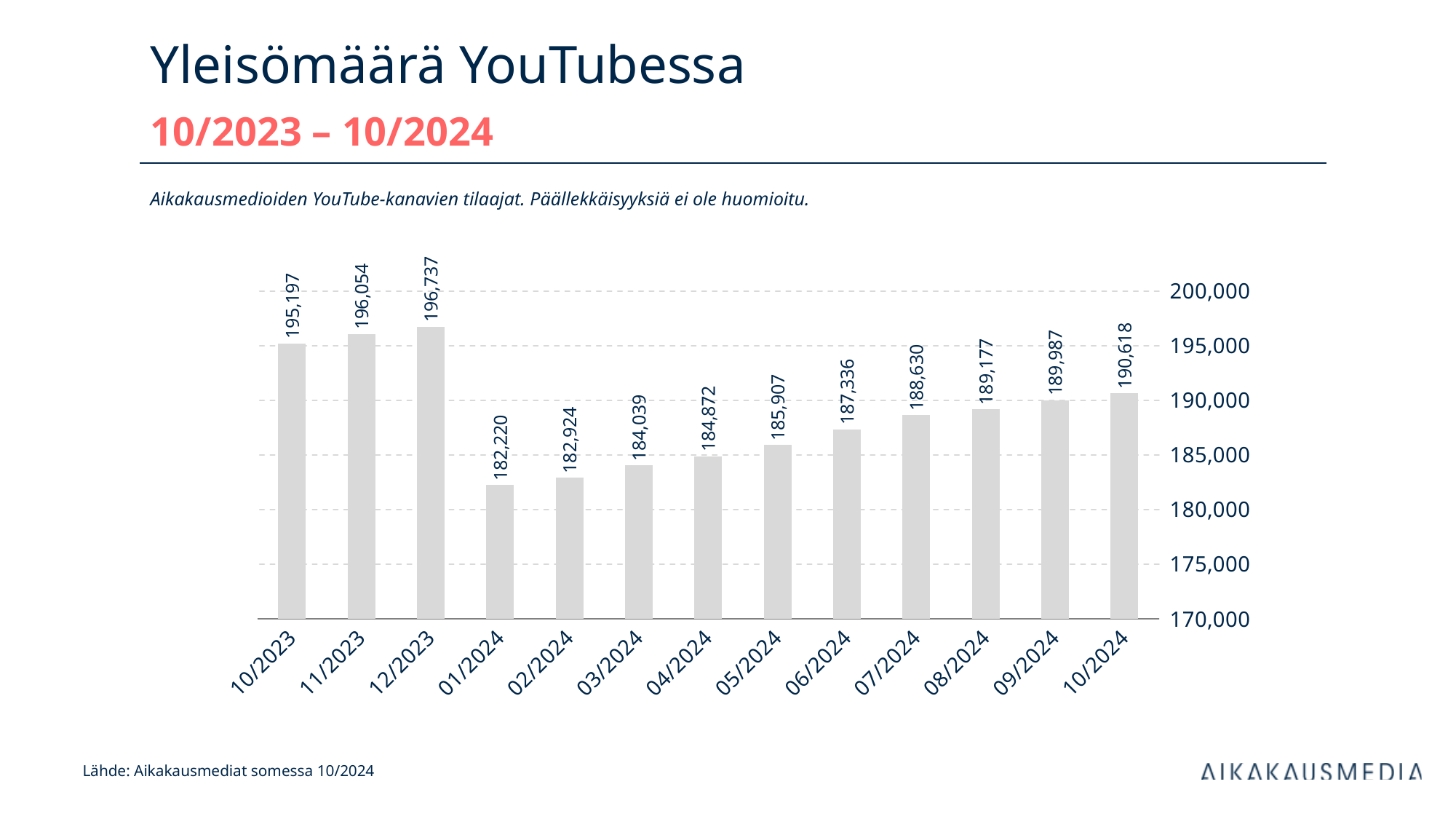
Which month has the lowest value? 01/2024 How many months are shown on the x axis? 13 Which is larger, the value for 03/2024 or the value for 05/2024? 05/2024 What is the value for 10/2024? 190,618 What is the difference between the values for 10/2023 and 10/2024? 4,579 Do the values rise or fall from 01/2024 to 10/2024? Rise What is the value for 01/2024? 182,220 What kind of chart is shown on the slide? Bar chart What is the difference between the values for 12/2023 and 01/2024? 14,517 Which month has the highest value? 12/2023 What is the value for 12/2023? 196,737 What is the value for 06/2024? 187,336